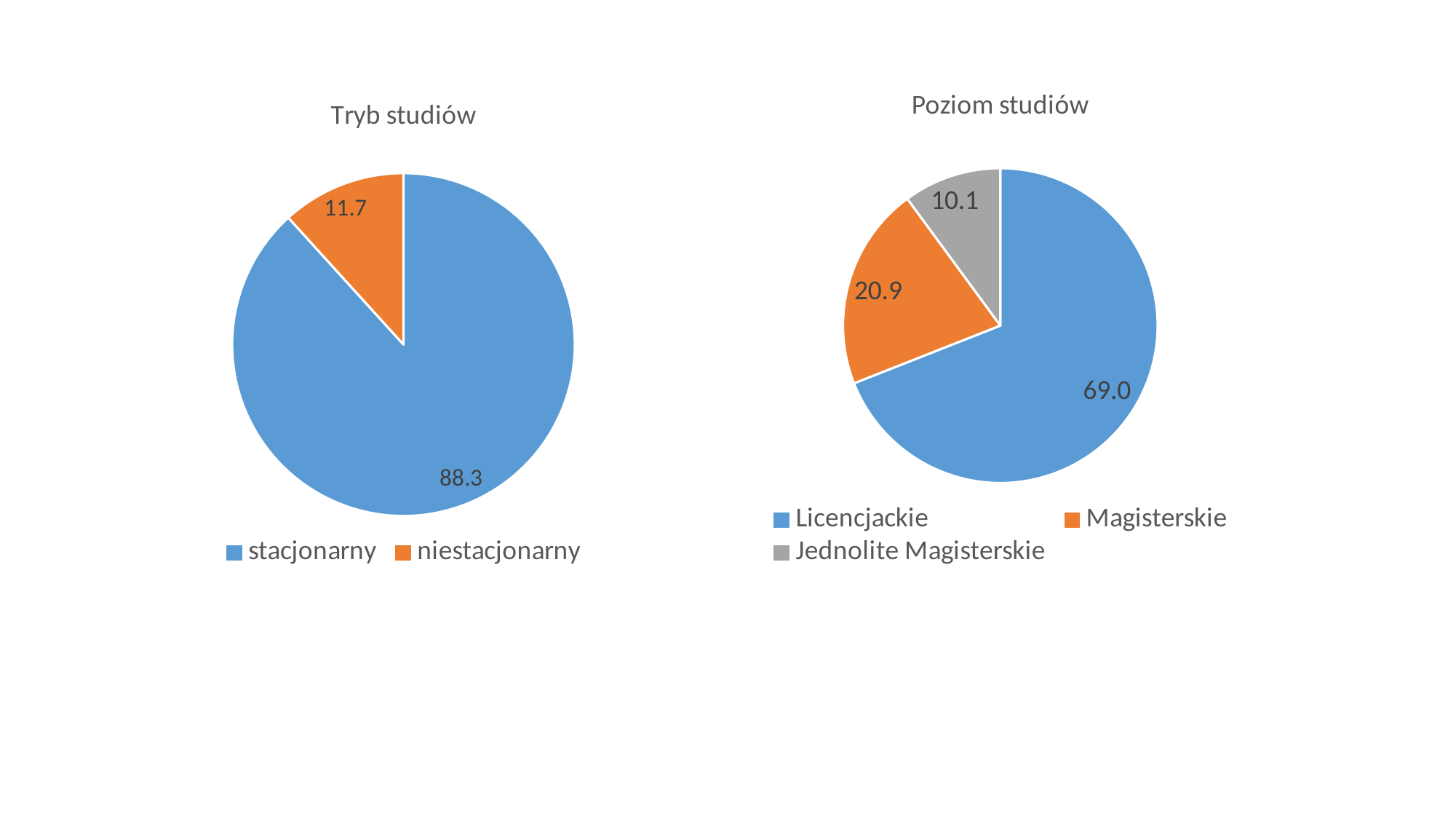
In the 'Poziom studiów' chart, how many entries does the legend list? 3 In the 'Poziom studiów' chart, what is the value for Magisterskie? 20.9 What kind of chart is 'Poziom studiów'? pie chart In the 'Tryb studiów' chart, what is the value for niestacjonarny? 11.7 In the 'Poziom studiów' chart, which is larger, Licencjackie or Magisterskie? Licencjackie In the 'Tryb studiów' chart, how many slices does the pie have? 2 In the 'Tryb studiów' chart, which category has the largest slice? stacjonarny In the 'Poziom studiów' chart, what is the difference between Magisterskie and Jednolite Magisterskie? 10.8 In the 'Tryb studiów' chart, what is the difference between stacjonarny and niestacjonarny? 76.6 In the 'Poziom studiów' chart, what is the value for Jednolite Magisterskie? 10.1 In the 'Tryb studiów' chart, what is the value for stacjonarny? 88.3 In the 'Poziom studiów' chart, which category has the smallest slice? Jednolite Magisterskie